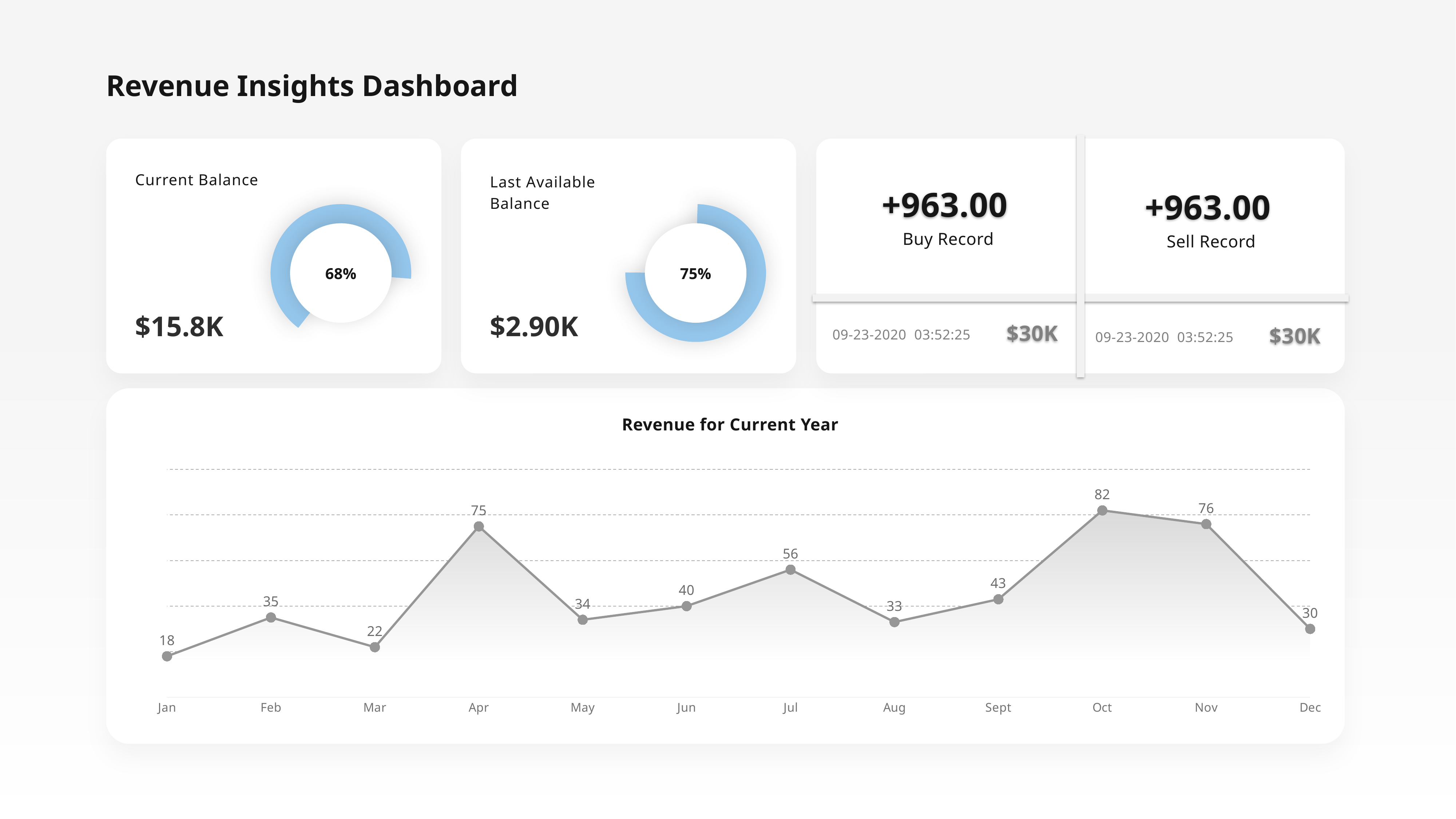
In the 'Revenue for Current Year' chart, what is the difference between the values for Jul and Aug? 23 In the 'Revenue for Current Year' chart, which month has the highest value? Oct What kind of chart is 'Revenue for Current Year'? line chart In the 'Revenue for Current Year' chart, what is the value for Apr? 75 How many months are plotted in the 'Revenue for Current Year' chart? 12 In the 'Revenue for Current Year' chart, what is the value for Sept? 43 In the 'Revenue for Current Year' chart, which is larger, the value for Apr or the value for Jul? Apr In the 'Revenue for Current Year' chart, what is the value for Dec? 30 In the 'Revenue for Current Year' chart, which month has the lowest value? Jan In the 'Revenue for Current Year' chart, what is the difference between the values for Oct and Nov? 6 What percentage is shown in the 'Current Balance' donut chart? 68% In the 'Revenue for Current Year' chart, do the values rise or fall from Sept to Oct? rise